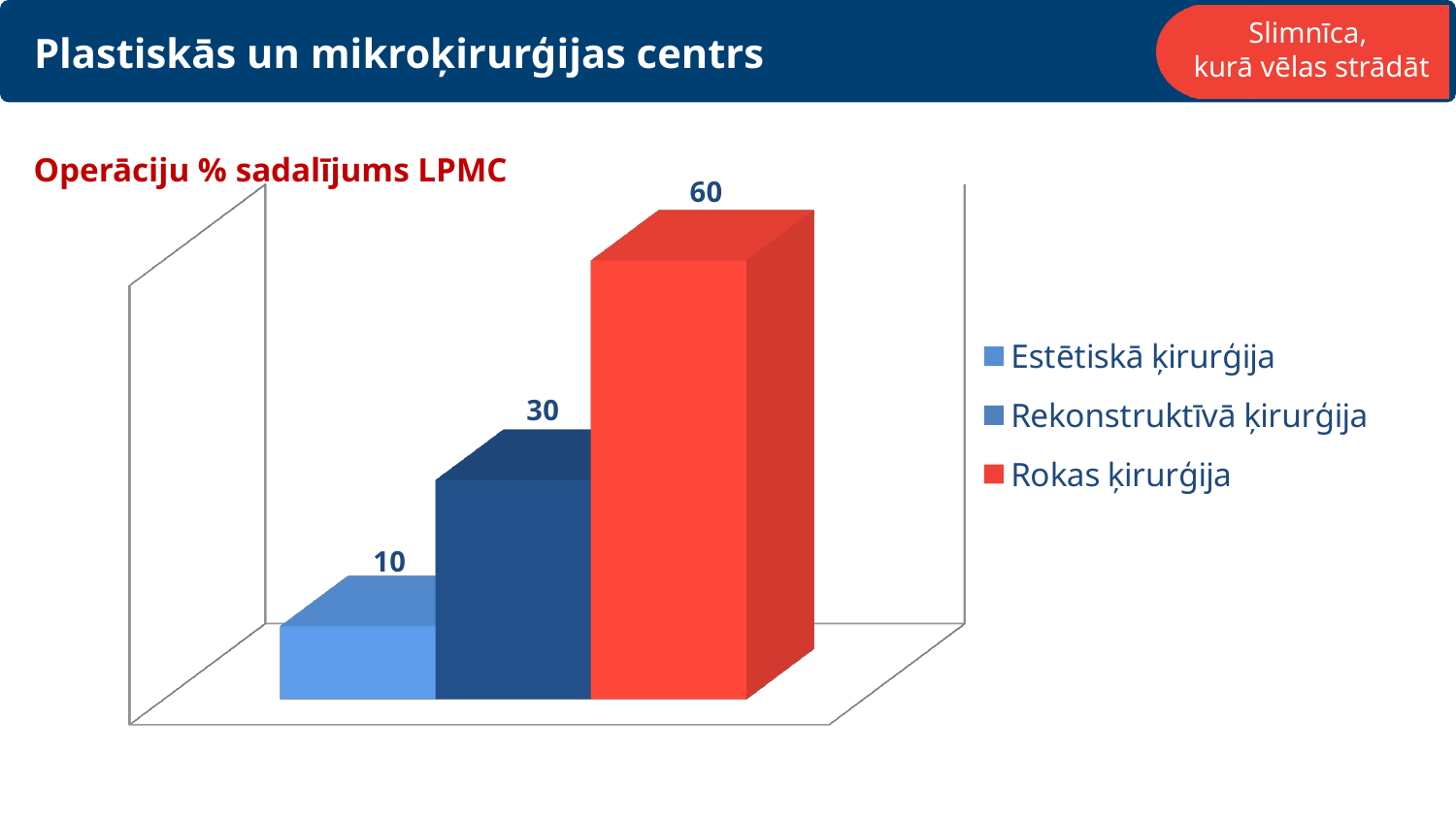
What is the difference between the values for Rokas ķirurģija and Rekonstruktīvā ķirurģija? 30 Which is larger, the value for Rekonstruktīvā ķirurģija or the value for Estētiskā ķirurģija? Rekonstruktīvā ķirurģija What kind of chart is shown on the slide? Bar chart What is the value for Estētiskā ķirurģija? 10 How many entries does the legend list? 3 What is the value for Rekonstruktīvā ķirurģija? 30 What is the title of the chart? Operāciju % sadalījums LPMC What is the value for Rokas ķirurģija? 60 Which category has the lowest value? Estētiskā ķirurģija Which category has the highest value? Rokas ķirurģija How many bars are plotted in the chart? 3 What is the difference between the values for Rekonstruktīvā ķirurģija and Estētiskā ķirurģija? 20